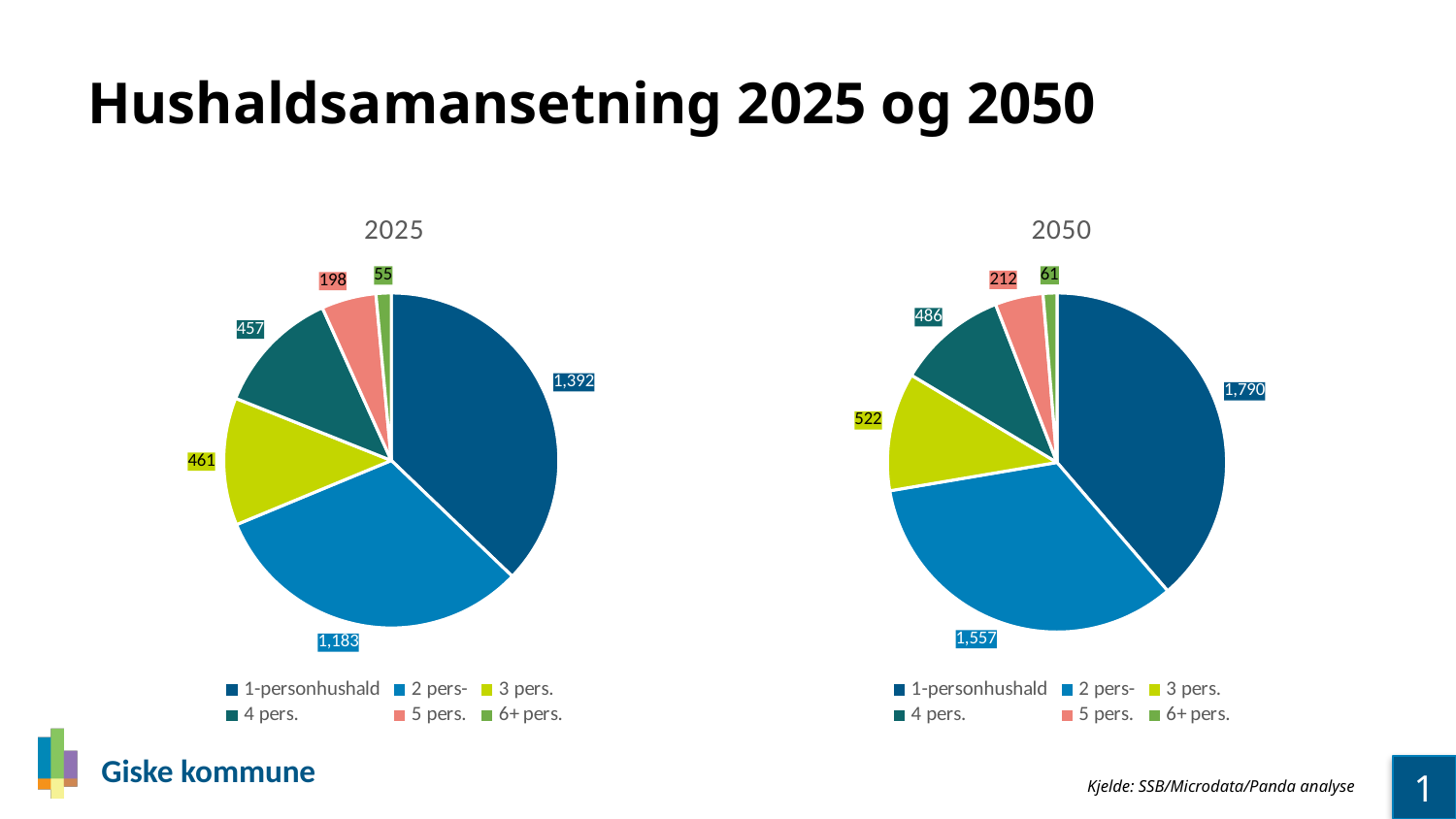
In the 2050 pie chart, what is the value for 2 pers-? 1,557 In the 2025 pie chart, what is the difference between the 1-personhushald and 2 pers- values? 209 What is the title of the left chart? 2025 In the 2025 pie chart, which category has the largest slice? 1-personhushald Which is larger: the 4 pers. value in the 2050 chart or the 4 pers. value in the 2025 chart? 2050 chart (486) In the 2025 pie chart, what is the value for 1-personhushald? 1,392 In the 2050 pie chart, which category has the smallest slice? 6+ pers. In the 2025 pie chart, what is the value for 5 pers.? 198 What is the difference between the 1-personhushald value in the 2050 chart and in the 2025 chart? 398 In the 2050 pie chart, what is the value for 3 pers.? 522 How many categories does the 2025 pie chart show? 6 What type of chart is used for the 2050 data? Pie chart